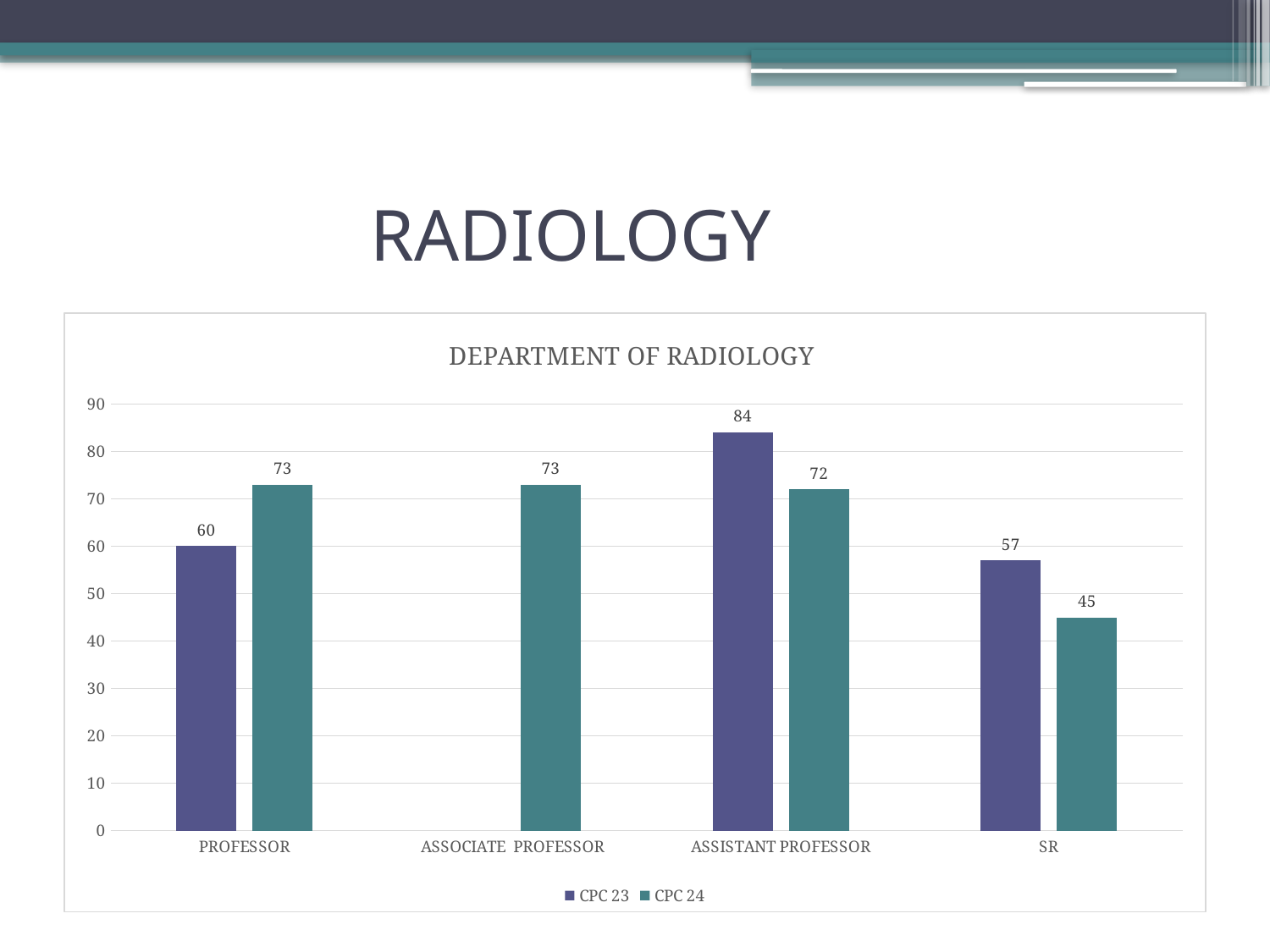
How many series does the legend list? 2 What is the CPC 24 value for SR? 45 What is the difference between the CPC 24 and CPC 23 values for PROFESSOR? 13 What is the title of the chart? DEPARTMENT OF RADIOLOGY What kind of chart is shown on the slide? bar chart How many categories are shown on the x axis? 4 What is the CPC 24 value for ASSISTANT PROFESSOR? 72 Is the CPC 23 value for ASSISTANT PROFESSOR greater or less than 80? greater Which category has the lowest CPC 24 value? SR Which category has the highest CPC 23 value? ASSISTANT PROFESSOR What is the CPC 23 value for PROFESSOR? 60 Which is larger for SR, the CPC 23 value or the CPC 24 value? CPC 23